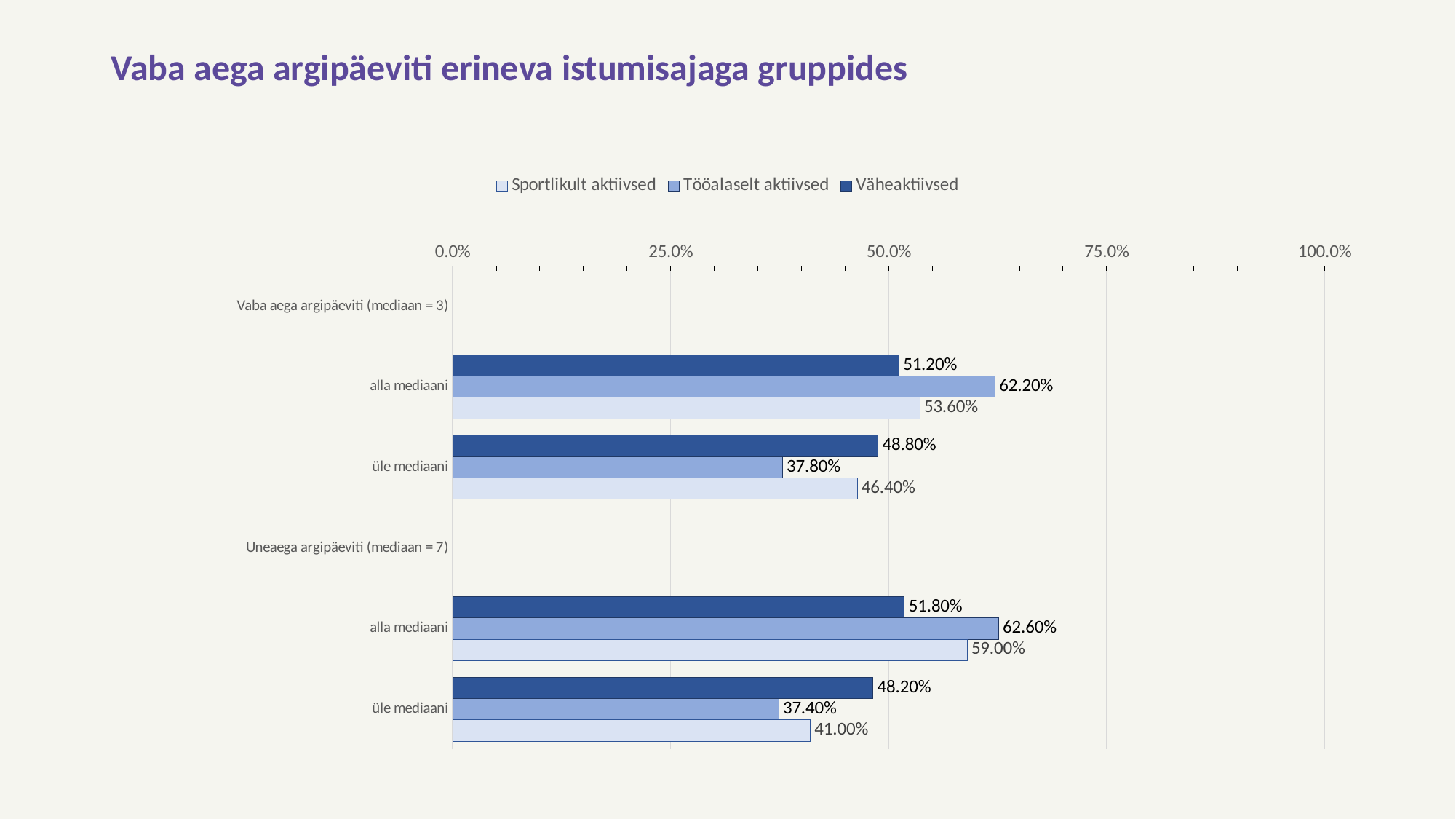
Which series has the highest value in the 'alla mediaani' group under 'Uneaega argipäeviti (mediaan = 7)'? Tööalaselt aktiivsed How many series does the legend list? 3 What kind of chart is shown on the slide? bar chart Which is larger: the Sportlikult aktiivsed value for 'alla mediaani' under 'Vaba aega argipäeviti (mediaan = 3)' or for 'alla mediaani' under 'Uneaega argipäeviti (mediaan = 7)'? Uneaega argipäeviti (mediaan = 7) alla mediaani Is the Tööalaselt aktiivsed value for 'üle mediaani' under 'Uneaega argipäeviti (mediaan = 7)' greater or less than 50.0%? less What is the value for Väheaktiivsed in the 'üle mediaani' group under 'Vaba aega argipäeviti (mediaan = 3)'? 48.80% Which series has the lowest value in the 'üle mediaani' group under 'Uneaega argipäeviti (mediaan = 7)'? Tööalaselt aktiivsed What is the value for Tööalaselt aktiivsed in the 'alla mediaani' group under 'Vaba aega argipäeviti (mediaan = 3)'? 62.20% What is the difference between the Tööalaselt aktiivsed values for 'alla mediaani' and 'üle mediaani' under 'Vaba aega argipäeviti (mediaan = 3)'? 24.40% What is the value for Sportlikult aktiivsed in the 'üle mediaani' group under 'Uneaega argipäeviti (mediaan = 7)'? 41.00% What is the title of the slide? Vaba aega argipäeviti erineva istumisajaga gruppides What is the difference between the Väheaktiivsed and Sportlikult aktiivsed values for 'alla mediaani' under 'Uneaega argipäeviti (mediaan = 7)'? 7.20%